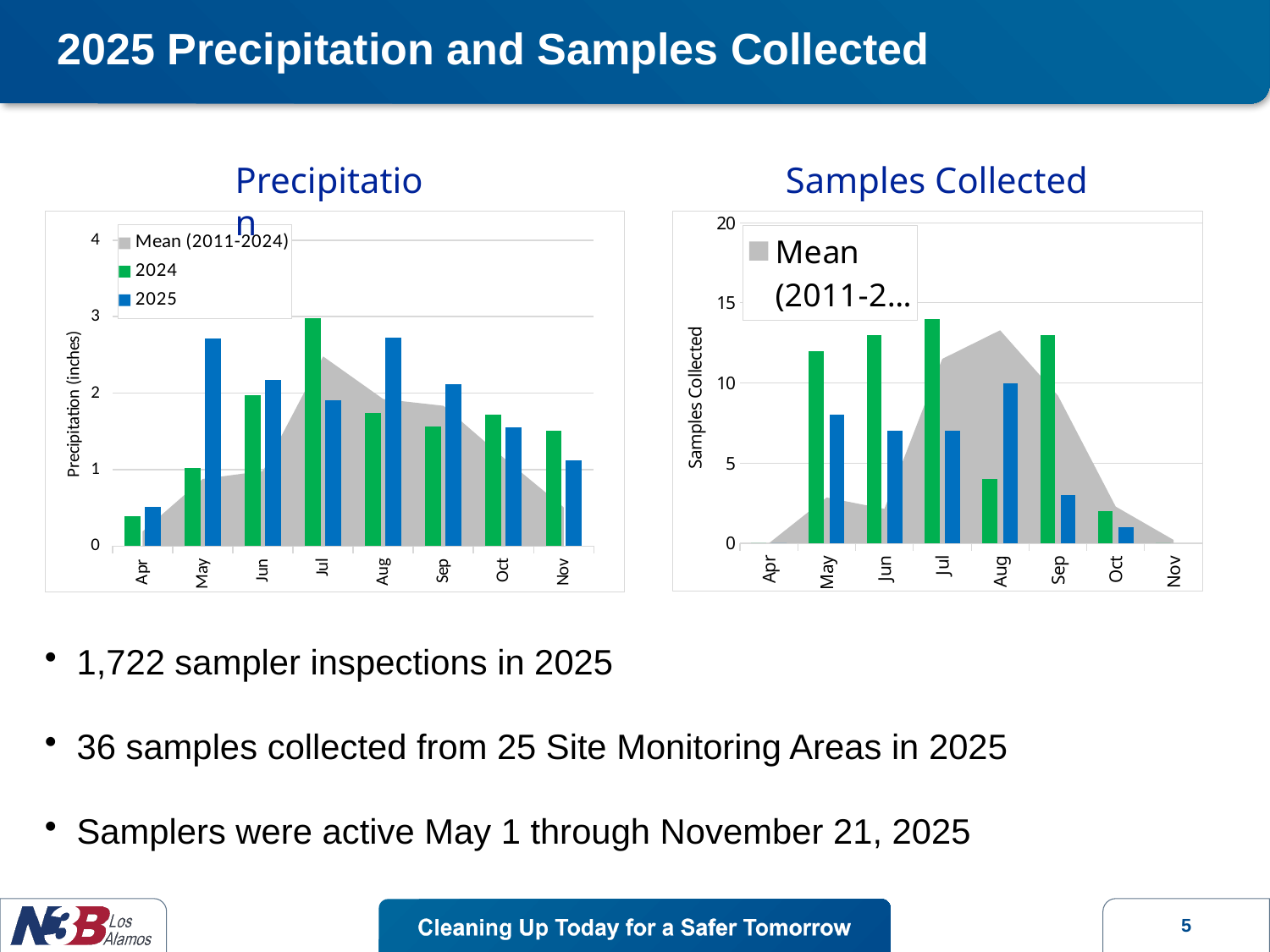
In the Samples Collected chart, is the green bar for Jul greater or less than 10? greater In the Precipitation chart, is the 2024 value for Apr greater or less than 1? less In the Precipitation chart, is the 2025 value for May greater or less than 2? greater In the Precipitation chart, which is larger for Jul, the 2024 value or the 2025 value? 2024 In the Precipitation chart, which month has the highest 2024 value? Jul How many months are shown on the x axis of the Precipitation chart? 8 In the Samples Collected chart, which month has the lowest blue bar? Oct In the Precipitation chart, which month has the lowest 2025 value? Apr What is the y-axis title of the Precipitation chart? Precipitation (inches) What kind of chart is the Precipitation chart on the left? combination bar and area chart How many series does the legend of the Precipitation chart list? 3 In the Samples Collected chart, do the blue bars rise or fall from Aug to Oct? fall